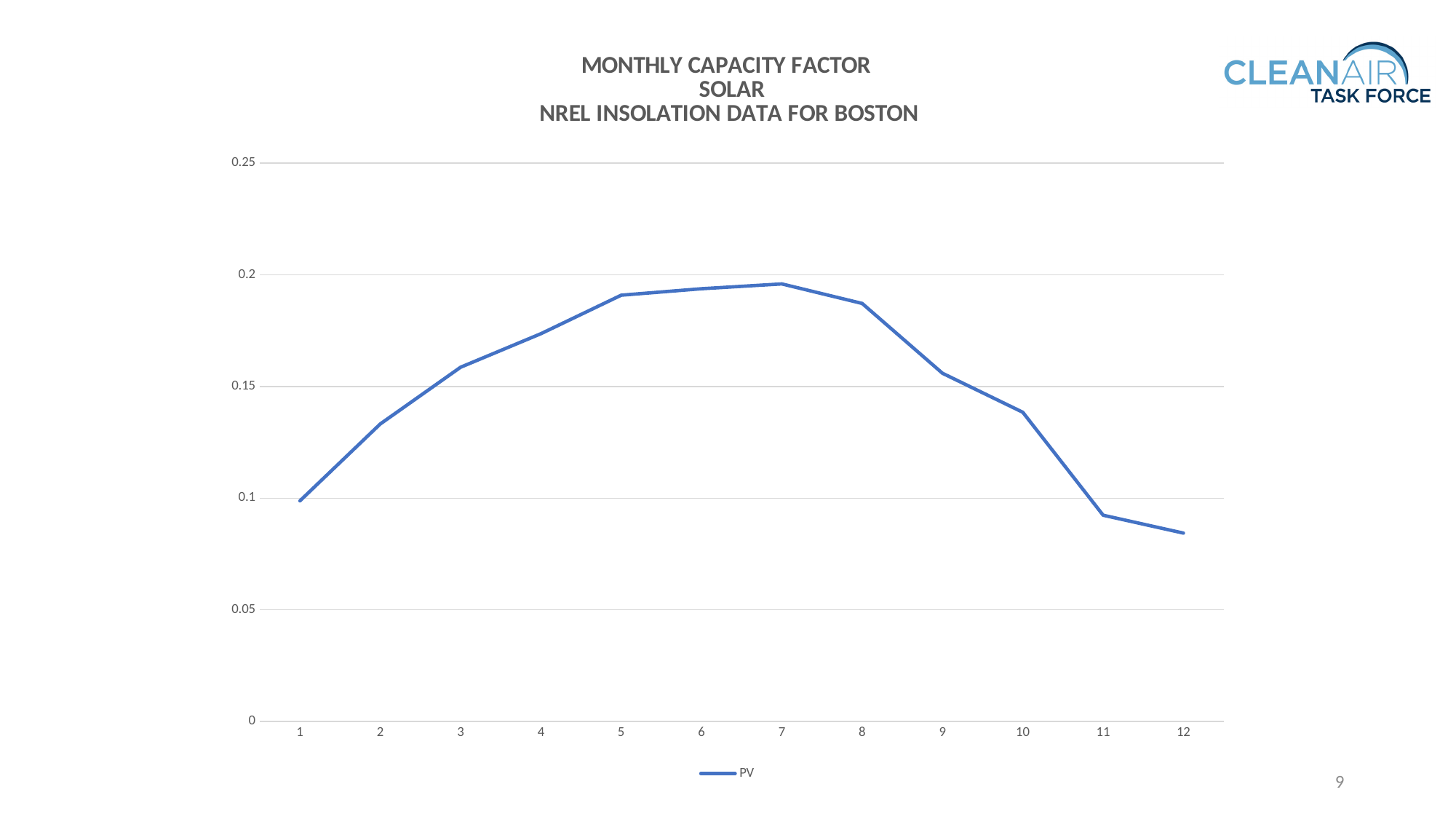
Is the PV value for month 5 greater or less than 0.2? less What is the name of the series shown in the legend? PV Is the PV value for month 12 greater or less than 0.1? less Which month has the highest PV capacity factor? 7 How many points are plotted along the x axis? 12 What kind of chart is shown on the slide? line chart Is the PV value for month 2 greater or less than 0.15? less How many series does the legend list? 1 Which month has the lowest PV capacity factor? 12 Does the PV line rise or fall from month 7 to month 12? fall Which is larger, the PV value for month 4 or for month 11? month 4